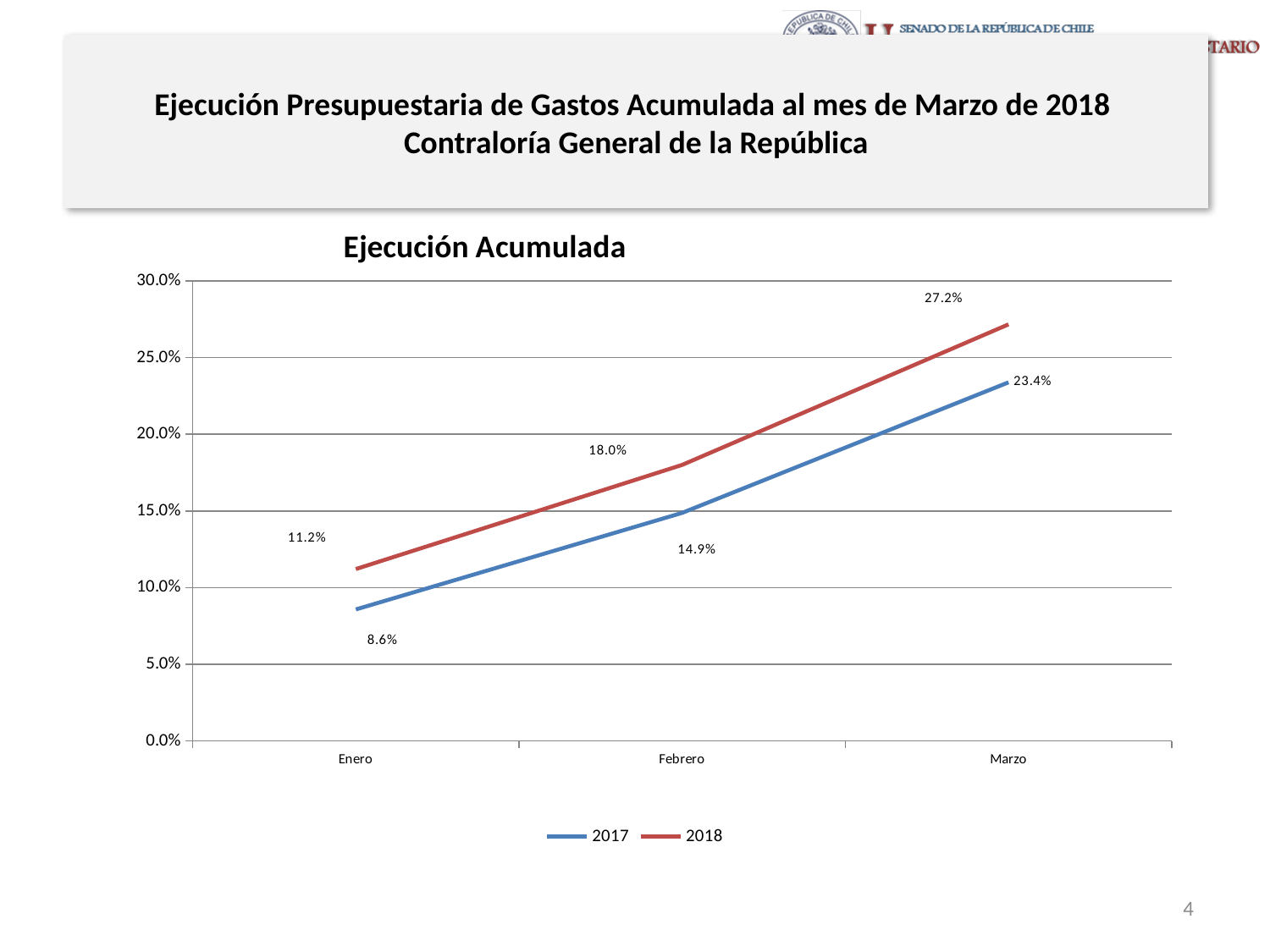
What is the value for 2018 in Marzo? 27.2% Which month has the lowest value for the 2017 series? Enero How many months are shown on the x axis? 3 What is the value for 2017 in Marzo? 23.4% What is the difference between the 2018 and 2017 values in Marzo? 3.8% Which month has the highest value for the 2018 series? Marzo What is the value for 2018 in Febrero? 18.0% How many series does the legend list? 2 What kind of chart is shown? Line chart Do the values for 2017 rise or fall from Enero to Marzo? Rise Which series has the larger value in Febrero, 2017 or 2018? 2018 What is the value for 2017 in Enero? 8.6%